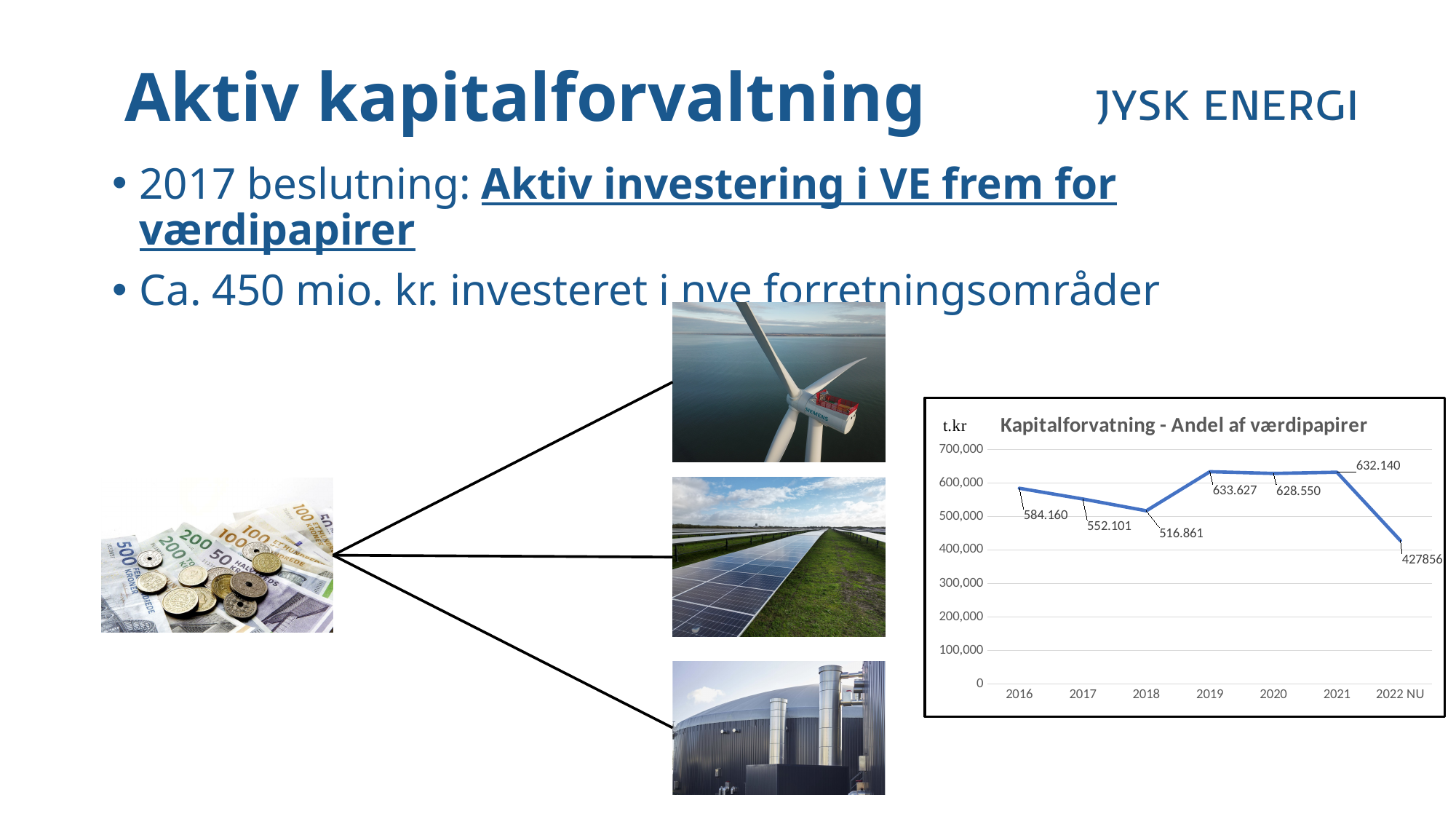
How many data points are plotted on the chart? 7 What is the title of the chart? Kapitalforvatning - Andel af værdipapirer Do the values rise or fall from 2016 to 2018? fall Is the value for 2019 or 2021 larger? 2019 What is the value for 2018 in the chart? 516.861 What is the difference between the values for 2016 and 2017? 32.059 Is the value for 2018 greater or less than 600,000? less Which category has the lowest value in the chart? 2022 NU What is the value for 2022 NU in the chart? 427856 What is the value for 2016 in the chart? 584.160 What type of chart is shown on the slide? line chart Which year has the highest value in the chart? 2019